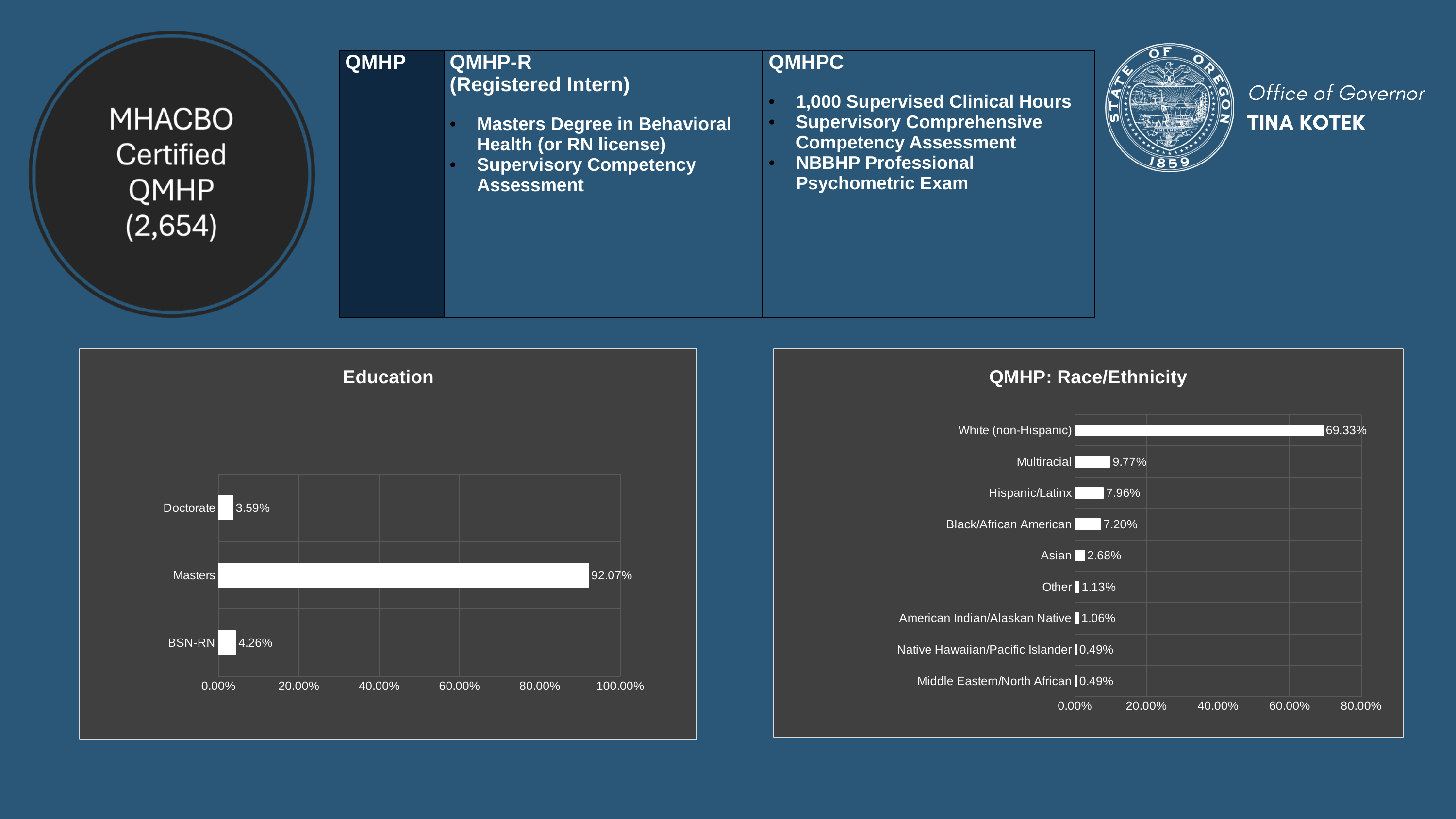
In the QMHP: Race/Ethnicity chart, which category has the highest value? White (non-Hispanic) In the QMHP: Race/Ethnicity chart, what is the difference between the Multiracial and Hispanic/Latinx values? 1.81% In the QMHP: Race/Ethnicity chart, how many categories are shown? 9 In the Education chart, what is the value for Masters? 92.07% In the Education chart, which category has the lowest value? Doctorate In the QMHP: Race/Ethnicity chart, which is larger, Hispanic/Latinx or Asian? Hispanic/Latinx In the QMHP: Race/Ethnicity chart, what is the value for Black/African American? 7.20% In the Education chart, what is the value for BSN-RN? 4.26% In the Education chart, how many categories are shown? 3 In the QMHP: Race/Ethnicity chart, what is the value for Multiracial? 9.77% What kind of chart is the Education chart? Bar chart In the Education chart, what is the difference between the Masters and Doctorate values? 88.48%